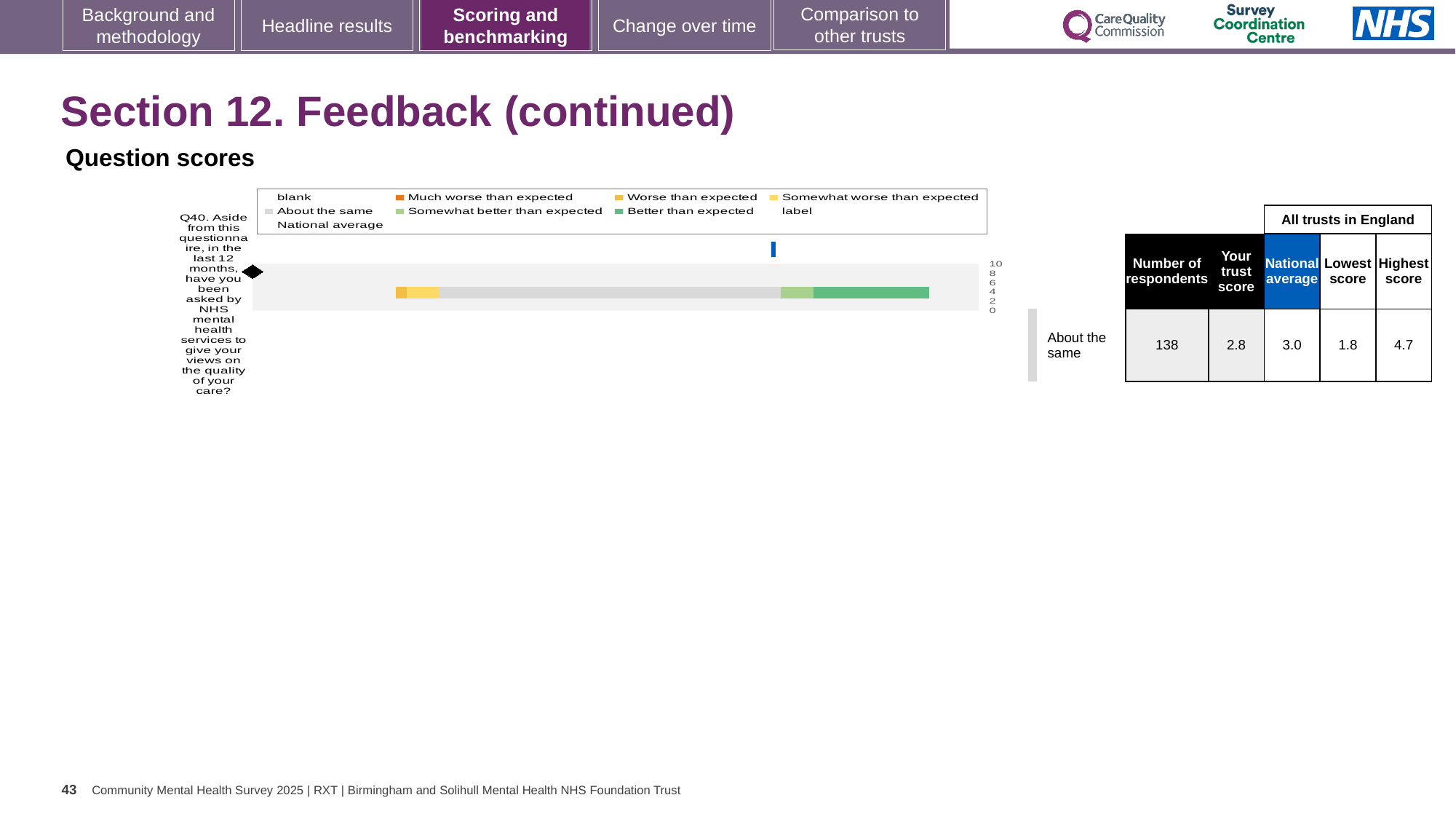
How many entries does the chart's legend list? 9 What kind of chart is shown on the slide? bar chart What is the lowest score among all trusts in England for Q40? 1.8 Which is larger for Q40, the trust score or the national average? national average What is the highest value shown on the chart's axis? 10 What is the difference between the highest score and the lowest score for Q40? 2.9 What is the trust's score for Q40 as printed in the table beside the chart? 2.8 Which question number is plotted on the chart? Q40 What is the highest score among all trusts in England for Q40? 4.7 What is the national average for Q40 as printed in the table beside the chart? 3.0 How many question categories are plotted on the chart? 1 How many respondents answered Q40? 138